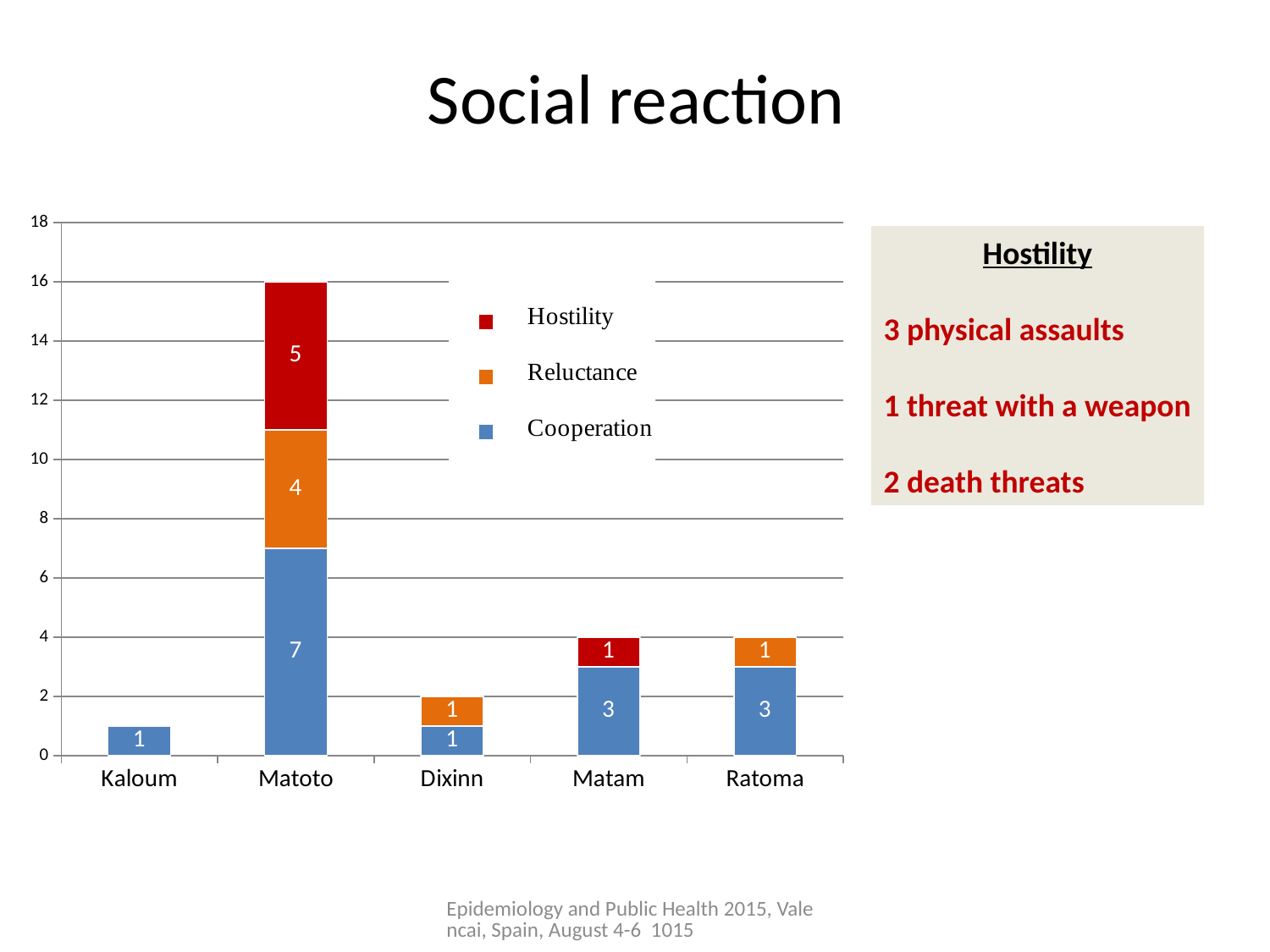
What is the Hostility value for Matam? 1 What is the total of the stacked bar for Ratoma? 4 What is the Hostility value for Matoto? 5 How many categories are shown on the x axis? 5 How many series does the legend list? 3 What is the difference between the Cooperation values for Matoto and Matam? 4 What kind of chart is shown on the slide? Stacked bar chart Which category has the shortest stacked bar? Kaloum What is the Cooperation value for Matoto? 7 What is the Reluctance value for Dixinn? 1 Which category has the tallest stacked bar? Matoto What is the total of the stacked bar for Matoto? 16